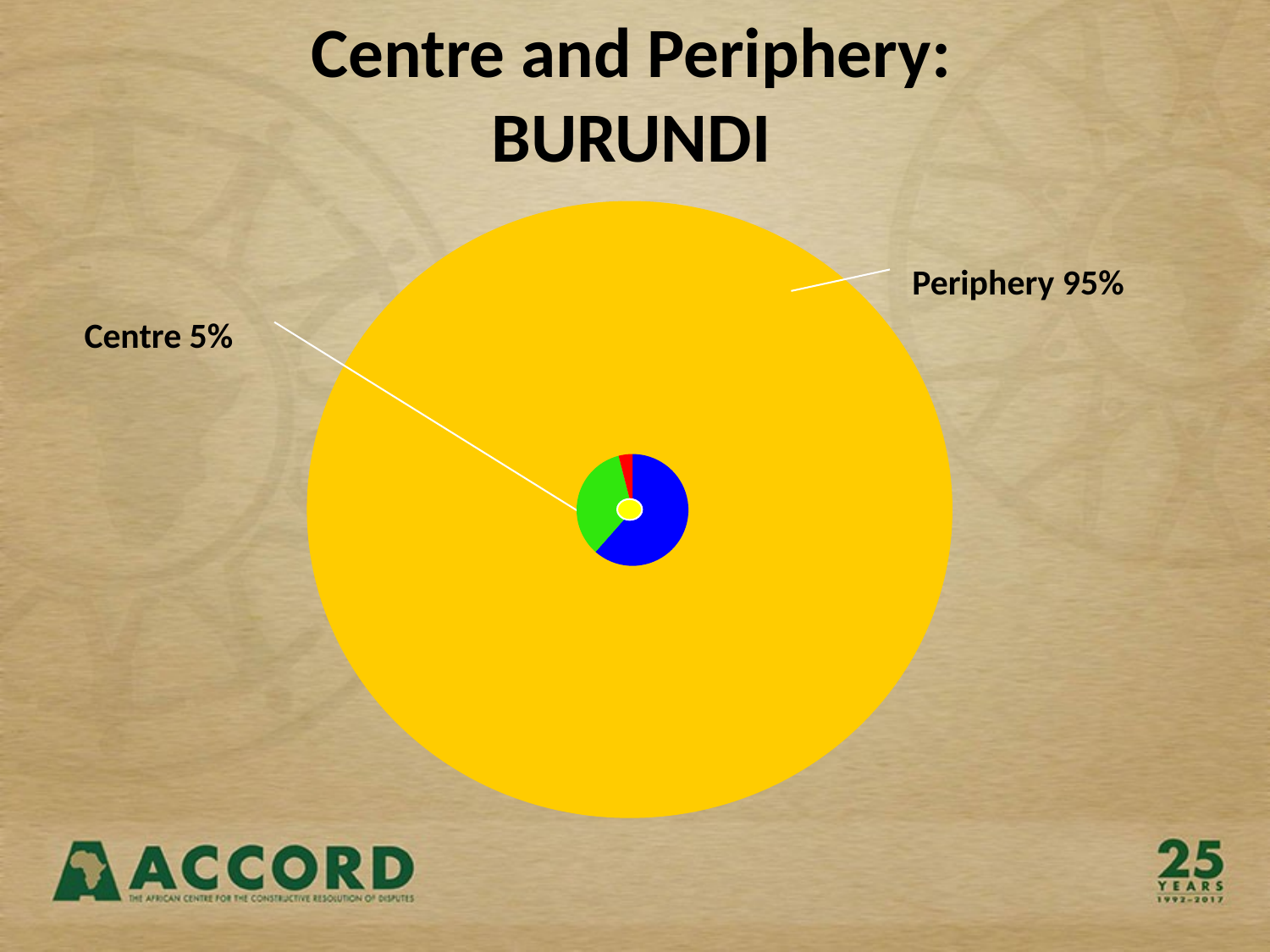
How many labelled categories does the chart show? 2 What percentage is shown for Periphery? 95% By how many percentage points does Periphery exceed Centre? 90 percentage points Which category has the smallest share? Centre What colour is the Periphery portion of the chart? yellow What percentage is shown for Centre? 5% Is the value for Centre larger or smaller than the value for Periphery? smaller What share of the whole does Periphery represent? 95% What is the title of the slide? Centre and Periphery: BURUNDI What kind of chart is shown on the slide? pie chart Which category has the larger share, Centre or Periphery? Periphery